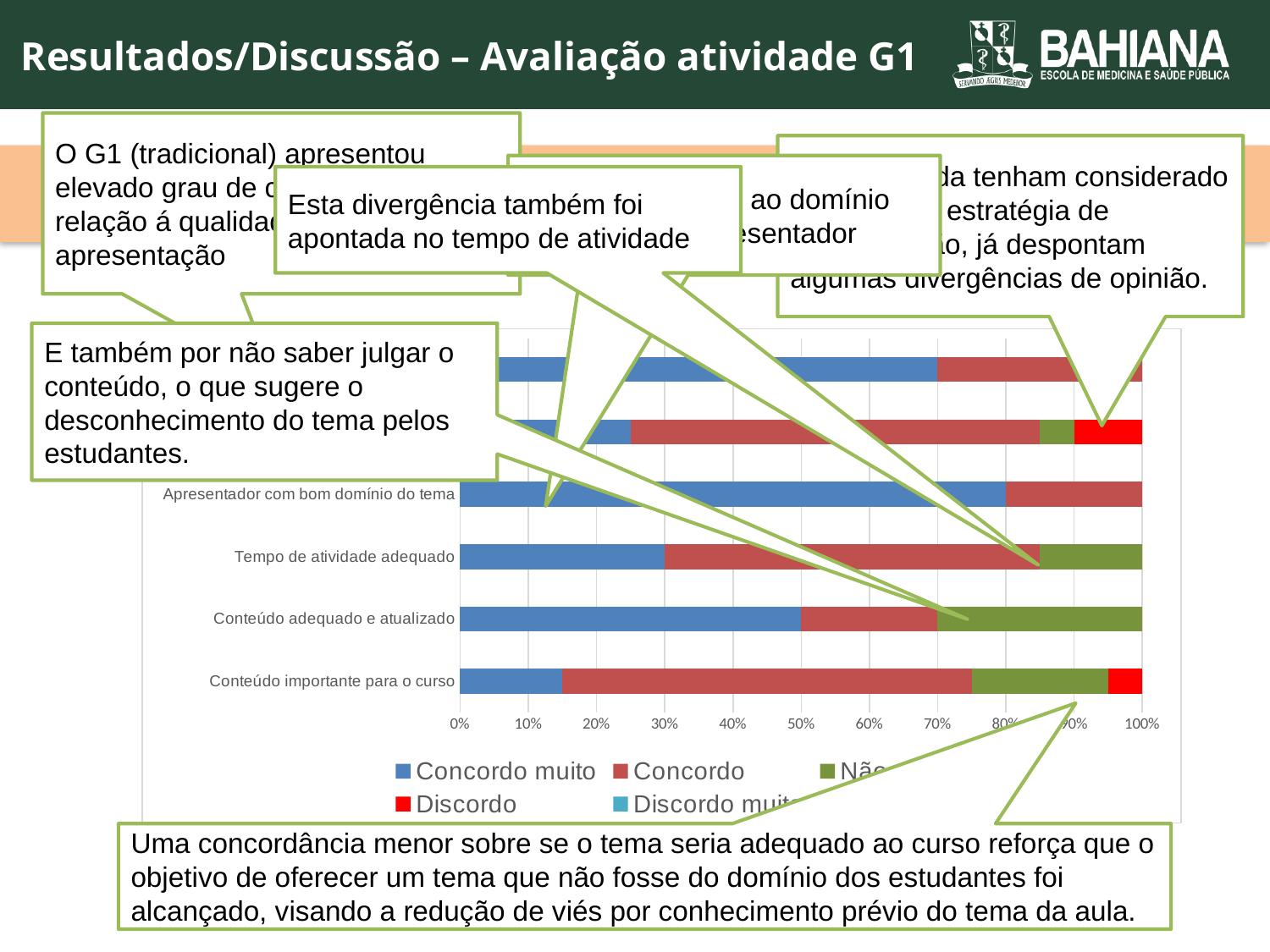
What colour represents 'Discordo' in the chart? Red How many series does the chart legend list? 5 Is the 'Concordo muito' share for 'Conteúdo importante para o curso' greater or less than 20%? less What is the 'Concordo muito' share for 'Conteúdo adequado e atualizado'? 50% Which has the larger 'Concordo muito' share: 'Conteúdo adequado e atualizado' or 'Tempo de atividade adequado'? Conteúdo adequado e atualizado What kind of chart is shown on the slide? Stacked bar chart Which is the first entry in the chart legend? Concordo muito Among the labelled categories, which has the smallest 'Concordo muito' share? Conteúdo importante para o curso Is the 'Concordo muito' share for 'Apresentador com bom domínio do tema' greater or less than 70%? greater What is the 'Concordo muito' share for 'Apresentador com bom domínio do tema'? 80% How many bars are plotted in the chart? 6 What is the 'Concordo muito' share for 'Tempo de atividade adequado'? 30%